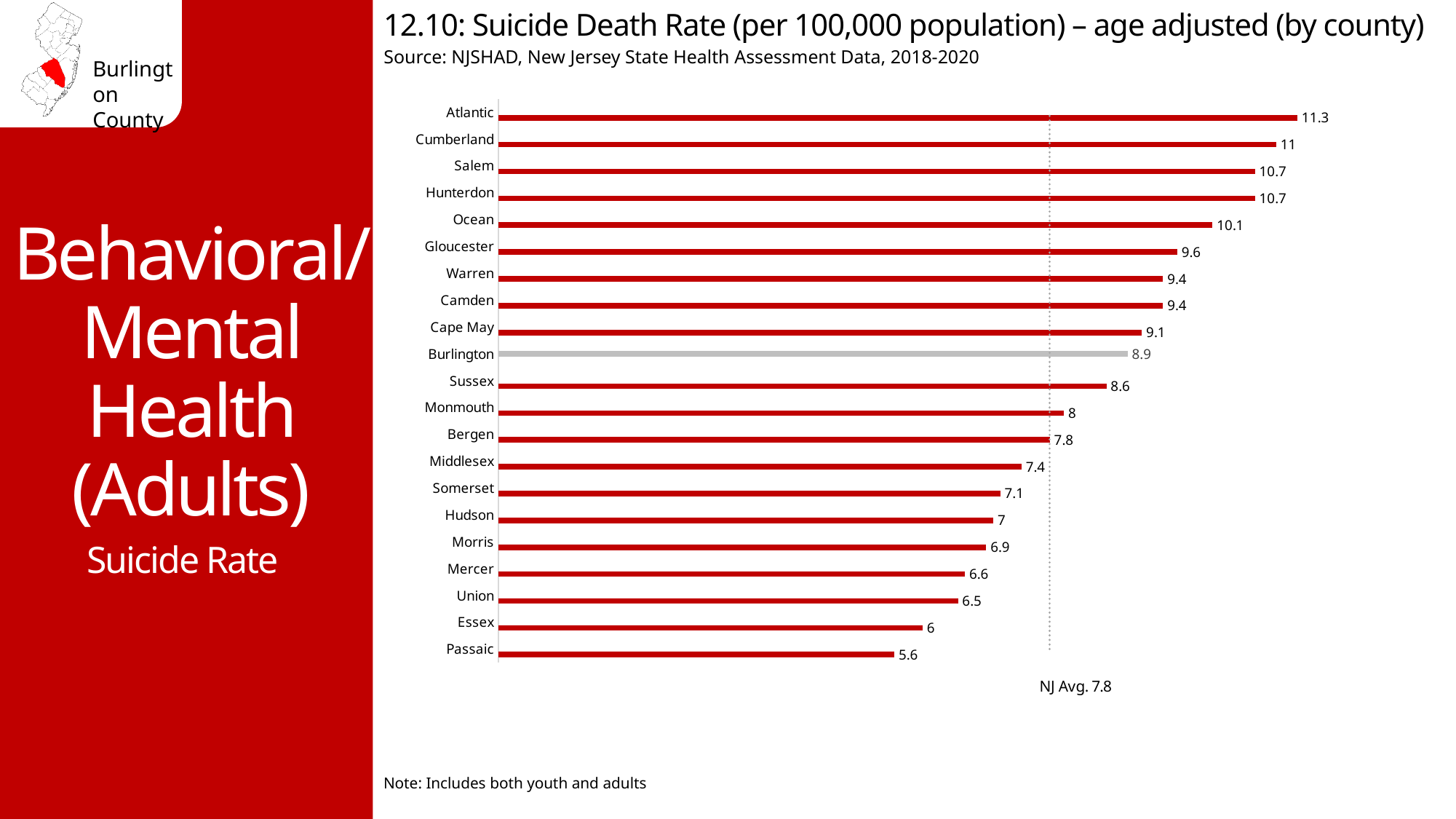
What is the suicide death rate for Passaic County? 5.6 Which has a higher suicide death rate, Essex or Mercer? Mercer Which county has the highest suicide death rate? Atlantic Which county has the lowest suicide death rate? Passaic What is the suicide death rate for Ocean County? 10.1 What is the NJ average suicide death rate indicated by the dotted line? 7.8 What is the difference between the suicide death rates of Atlantic and Burlington counties? 2.4 What is the suicide death rate for Burlington County? 8.9 How many counties are shown on the chart? 21 Which has a higher suicide death rate, Sussex or Monmouth? Sussex What is the difference between Burlington County's suicide death rate and the NJ average shown on the chart? 1.1 What type of chart is used on this slide? Bar chart